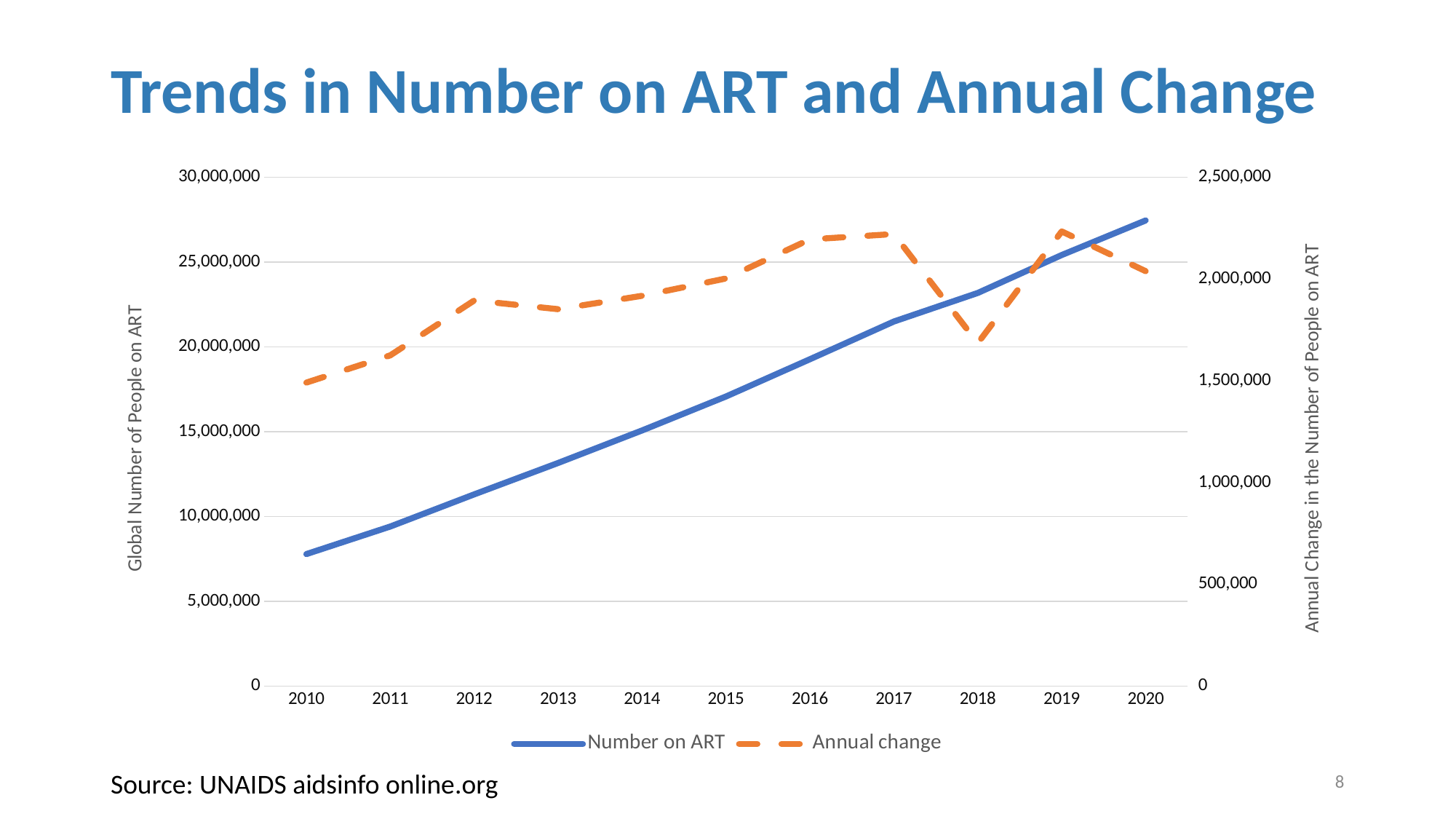
In which year is the Annual change lowest? 2010 Does the Number on ART rise or fall from 2010 to 2020? rise What kind of chart is shown on the slide? line chart In which year is the Number on ART highest? 2020 Is the Number on ART in 2020 greater or less than 25,000,000? greater What is the label of the right-hand vertical axis? Annual Change in the Number of People on ART Is the Annual change in 2018 greater or less than 2,000,000? less Which year has the larger Annual change, 2018 or 2019? 2019 In which year is the Number on ART lowest? 2010 Is the Number on ART in 2010 greater or less than 10,000,000? less How many years are plotted along the x axis? 11 How many series does the legend list? 2